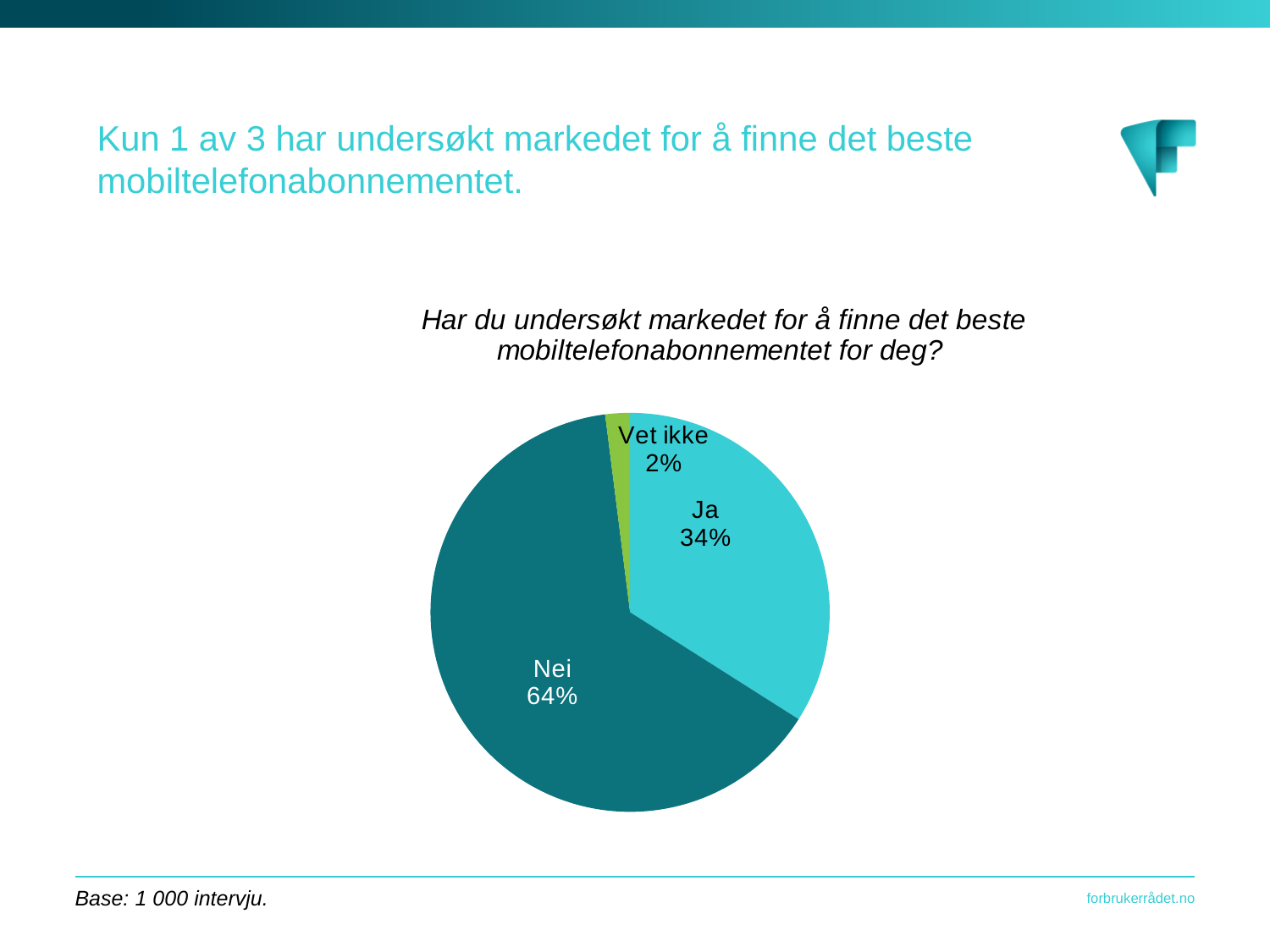
What is the combined share of "Ja" and "Vet ikke"? 36% What kind of chart is shown on the slide? pie chart What percentage of respondents answered "Nei"? 64% Which is larger, the share for "Ja" or the share for "Nei"? Nei What colour is the "Vet ikke" slice? green Which response has the smallest share of the pie? Vet ikke What is the difference in percentage points between "Nei" and "Ja"? 30 What percentage of respondents answered "Ja"? 34% What is the title of the pie chart? Har du undersøkt markedet for å finne det beste mobiltelefonabonnementet for deg? How many slices does the pie chart have? 3 What percentage of respondents answered "Vet ikke"? 2% Which response has the largest share of the pie? Nei